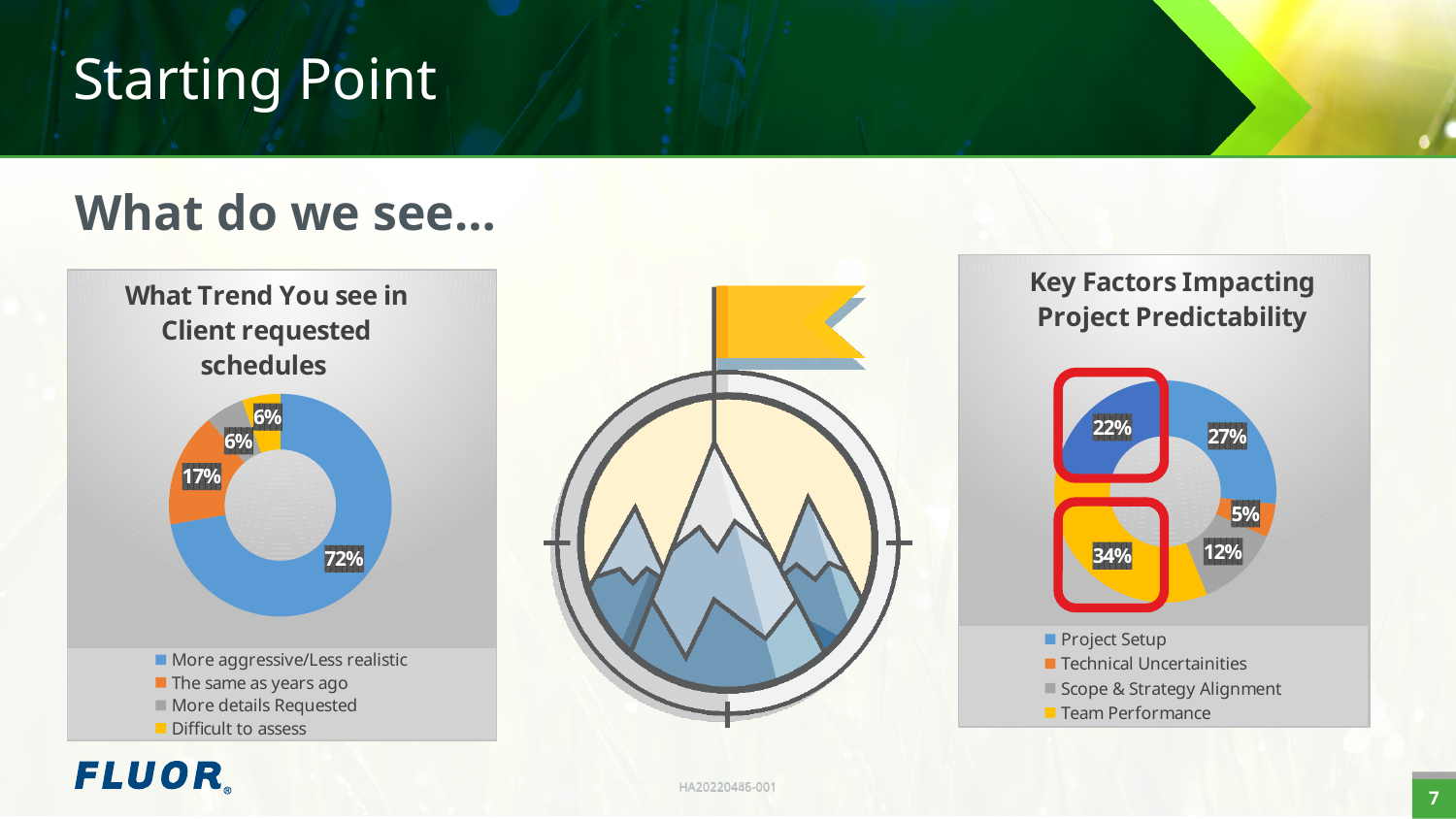
In the chart titled 'What Trend You see in Client requested schedules', what percentage is shown for 'More aggressive/Less realistic'? 72% In the chart titled 'What Trend You see in Client requested schedules', how many categories does the legend list? 4 In the chart titled 'Key Factors Impacting Project Predictability', what percentage is shown for 'Team Performance'? 34% In the chart titled 'Key Factors Impacting Project Predictability', what percentage is shown for 'Project Setup'? 27% In the chart titled 'What Trend You see in Client requested schedules', what is the difference in percentage points between 'More aggressive/Less realistic' and 'The same as years ago'? 55 percentage points In the chart titled 'Key Factors Impacting Project Predictability', how many entries does the legend list? 4 In the chart titled 'Key Factors Impacting Project Predictability', what percentage is shown for 'Scope & Strategy Alignment'? 12% In the chart titled 'Key Factors Impacting Project Predictability', which is larger: 'Project Setup' or 'Team Performance'? Team Performance In the chart titled 'What Trend You see in Client requested schedules', which category has the largest share? More aggressive/Less realistic In the chart titled 'What Trend You see in Client requested schedules', what percentage is shown for 'The same as years ago'? 17% What type of chart is the chart titled 'What Trend You see in Client requested schedules'? Doughnut (pie) chart In the chart titled 'Key Factors Impacting Project Predictability', which legend category has the smallest share? Technical Uncertainities